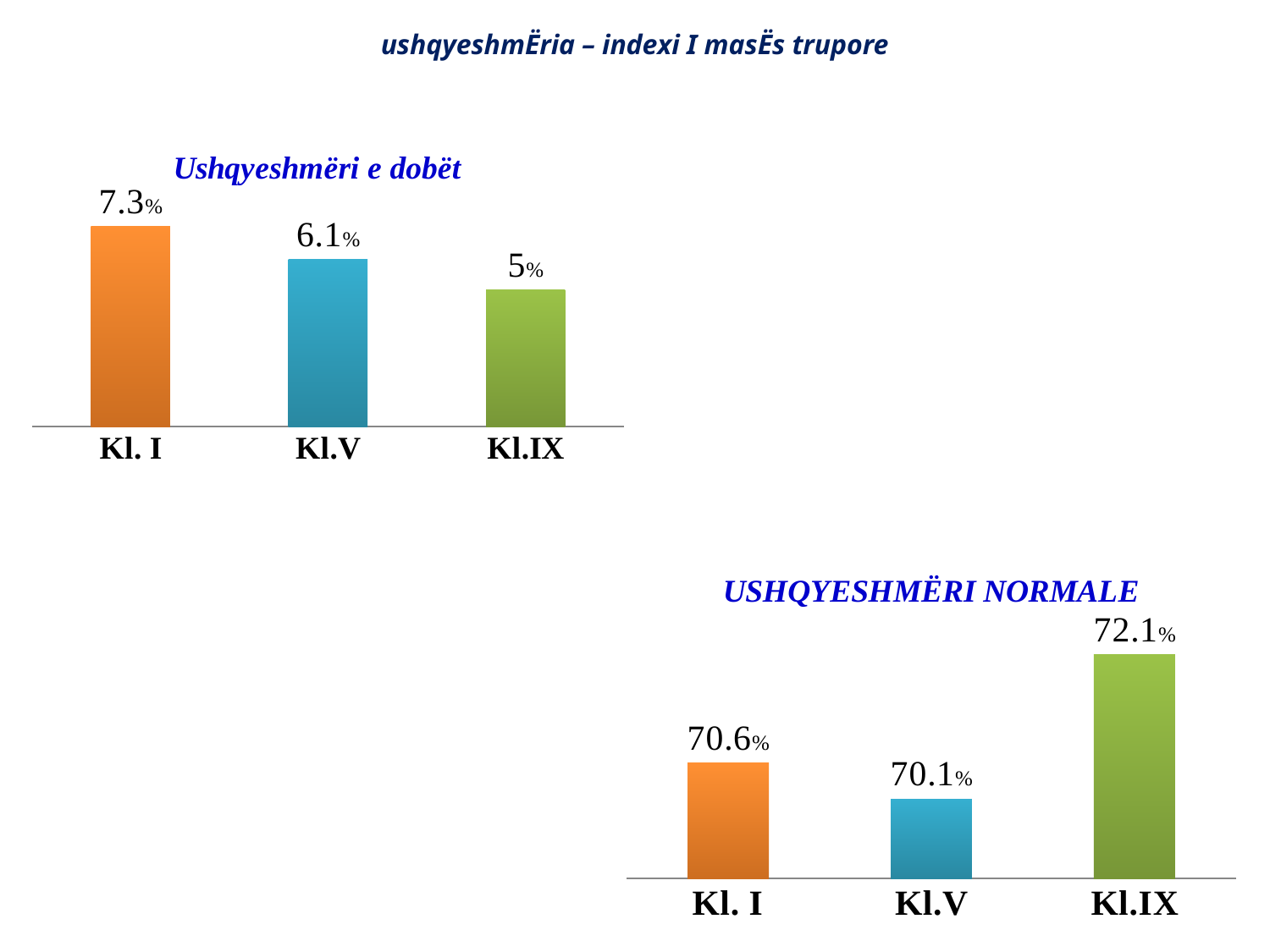
In the 'USHQYESHMËRI NORMALE' chart, what is the difference between the values for Kl.IX and Kl. I? 1.5% In the 'USHQYESHMËRI NORMALE' chart, which is larger, the value for Kl.IX or the value for Kl. I? Kl.IX In the 'USHQYESHMËRI NORMALE' chart, what is the value for Kl.V? 70.1% In the 'Ushqyeshmëri e dobët' chart, what is the value for Kl.IX? 5% In the 'Ushqyeshmëri e dobët' chart, what is the difference between the values for Kl. I and Kl.V? 1.2% How many categories are shown in the 'Ushqyeshmëri e dobët' chart? 3 In the 'Ushqyeshmëri e dobët' chart, which category has the highest value? Kl. I In the 'Ushqyeshmëri e dobët' chart, what is the value for Kl. I? 7.3% In the 'Ushqyeshmëri e dobët' chart, do the values rise or fall from Kl. I to Kl.IX? fall In the 'USHQYESHMËRI NORMALE' chart, what is the value for Kl.IX? 72.1% What kind of chart is the 'USHQYESHMËRI NORMALE' chart? bar chart In the 'USHQYESHMËRI NORMALE' chart, which category has the lowest value? Kl.V